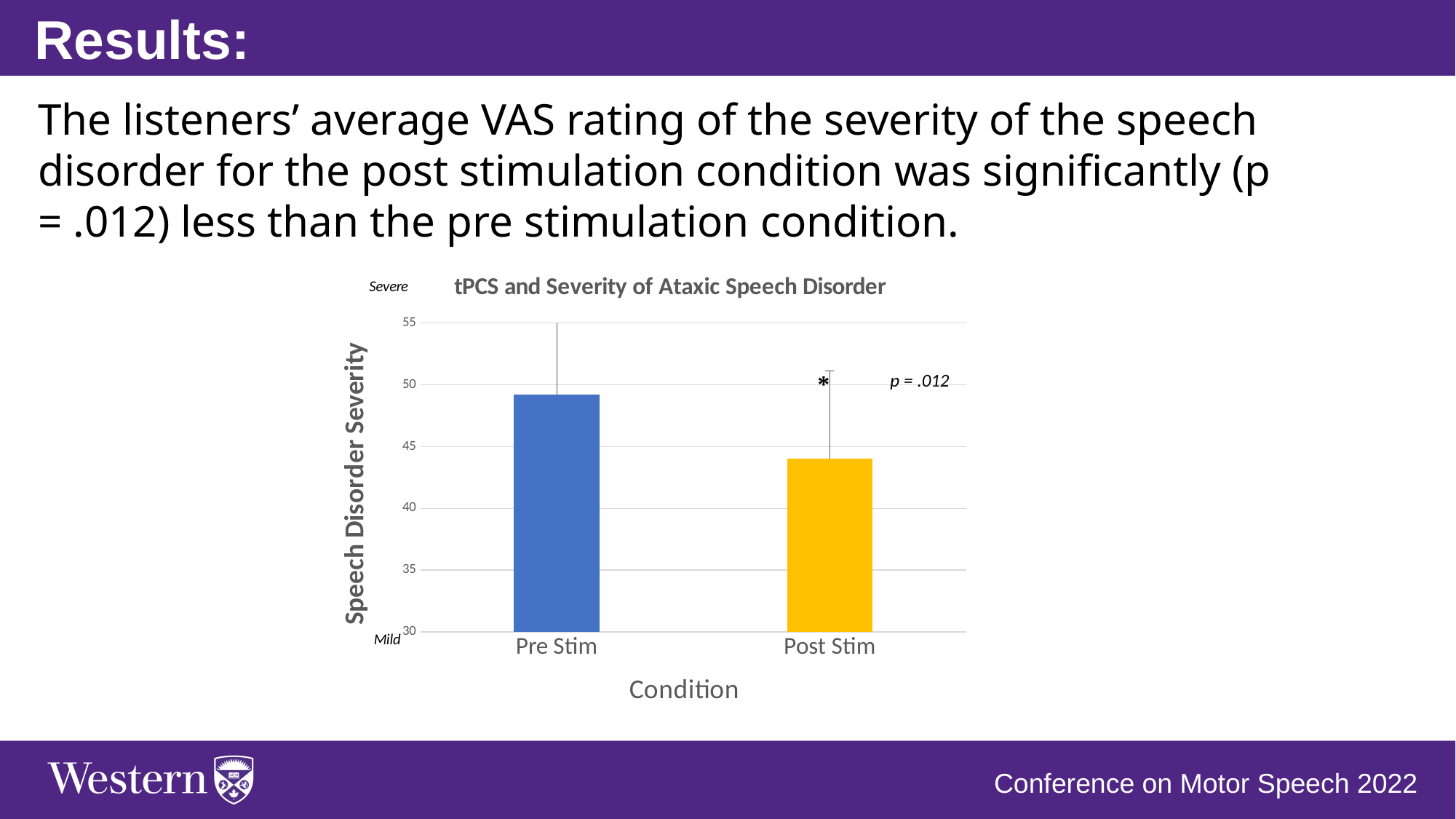
Which condition has the higher speech disorder severity? Pre Stim Is the value for Post Stim greater or less than 40? greater Is the value for Pre Stim greater or less than 45? greater What kind of chart is shown on the slide? Bar chart Is the severity value for Pre Stim larger or smaller than the value for Post Stim? Larger What p value is annotated on the chart? p = .012 What is the title of the chart? tPCS and Severity of Ataxic Speech Disorder How many conditions are plotted in the chart? 2 Which condition has the lower speech disorder severity? Post Stim Is the value for Pre Stim greater or less than 50? less